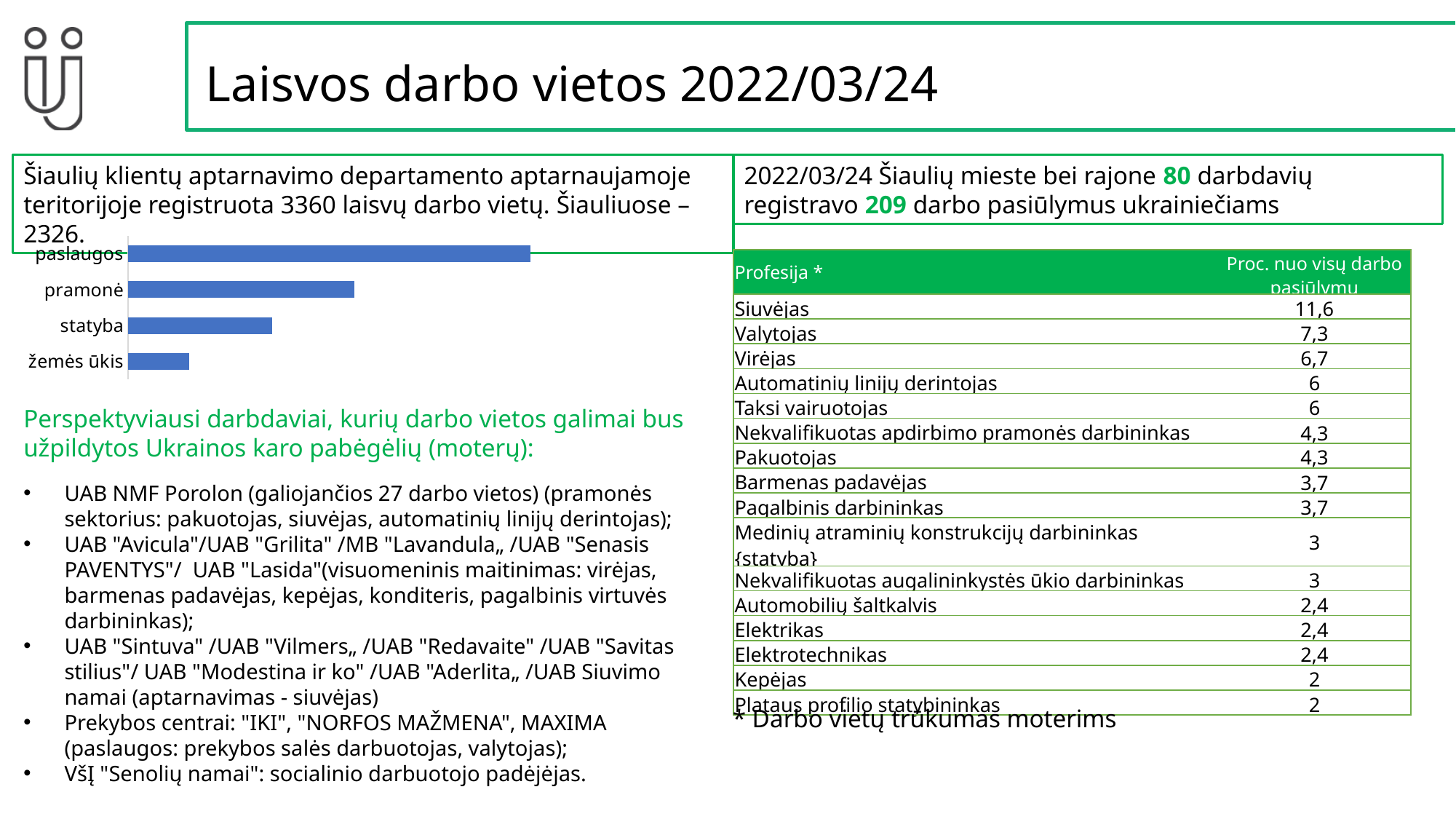
Which category has the longest bar in the bar chart? paslaugos What kind of chart is shown on the left side of the slide? bar chart Do the bar lengths increase or decrease going from the top category to the bottom category of the bar chart? decrease Are the bars in the chart horizontal or vertical? horizontal In the bar chart, which is larger: statyba or žemės ūkis? statyba In the bar chart, which is larger: pramonė or statyba? pramonė In the bar chart, which is larger: paslaugos or pramonė? paslaugos Which category is listed at the top of the bar chart? paslaugos How many categories does the bar chart show? 4 Which category has the shortest bar in the bar chart? žemės ūkis